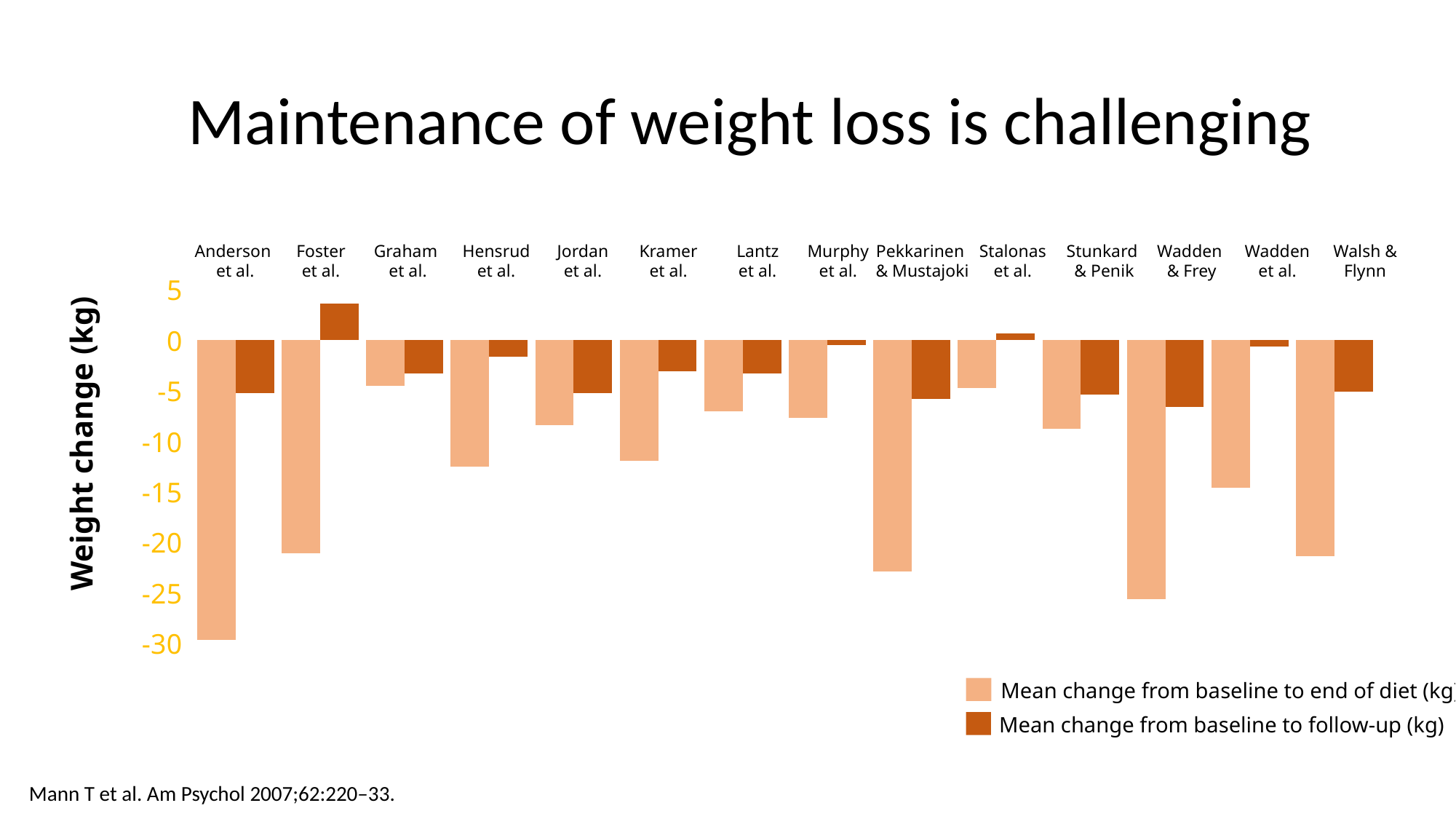
What is the title of the y axis? Weight change (kg) How many series does the legend list? 2 Which study has the lowest (most negative) mean change from baseline to end of diet? Anderson et al. Which study has the highest mean change from baseline to follow-up? Foster et al. What kind of chart is shown on the slide? bar chart Is the mean change from baseline to end of diet for Anderson et al. greater or less than -25? less Which is lower, the mean change from baseline to end of diet for Anderson et al. or for Foster et al.? Anderson et al. Is the mean change from baseline to follow-up for Murphy et al. greater or less than -5? greater Is the mean change from baseline to end of diet for Hensrud et al. greater or less than -10? less Which series is shown in the darker orange colour? Mean change from baseline to follow-up (kg) How many studies (categories) are plotted along the x axis? 14